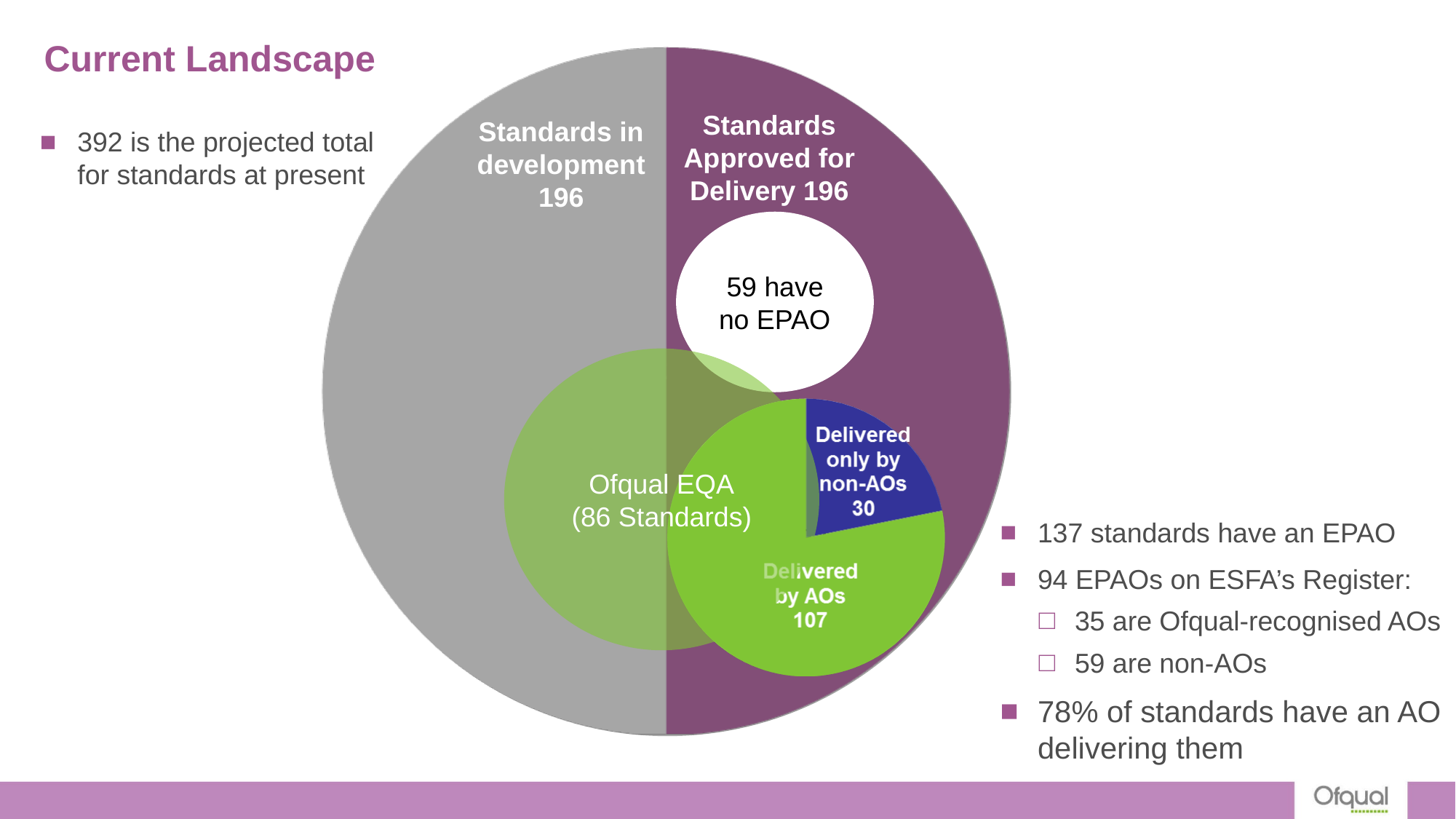
In the small pie chart, what is the value for Delivered only by non-AOs? 30 In the large pie chart, what is the value for Standards in development? 196 In the large pie chart, what is the value for Standards Approved for Delivery? 196 In the small pie chart, what is the difference between Delivered by AOs and Delivered only by non-AOs? 77 In the small pie chart, what is the value for Delivered by AOs? 107 In the large pie chart, how many slices are there? 2 In the large pie chart, what is the total of the two slices? 392 In the large pie chart, what colour is the Standards in development slice? grey In the small pie chart, which slice is the largest? Delivered by AOs What kind of chart is the large circular chart on the slide? pie chart In the small pie chart, which slice is the smallest? Delivered only by non-AOs In the small pie chart, what is the total of the two slices? 137